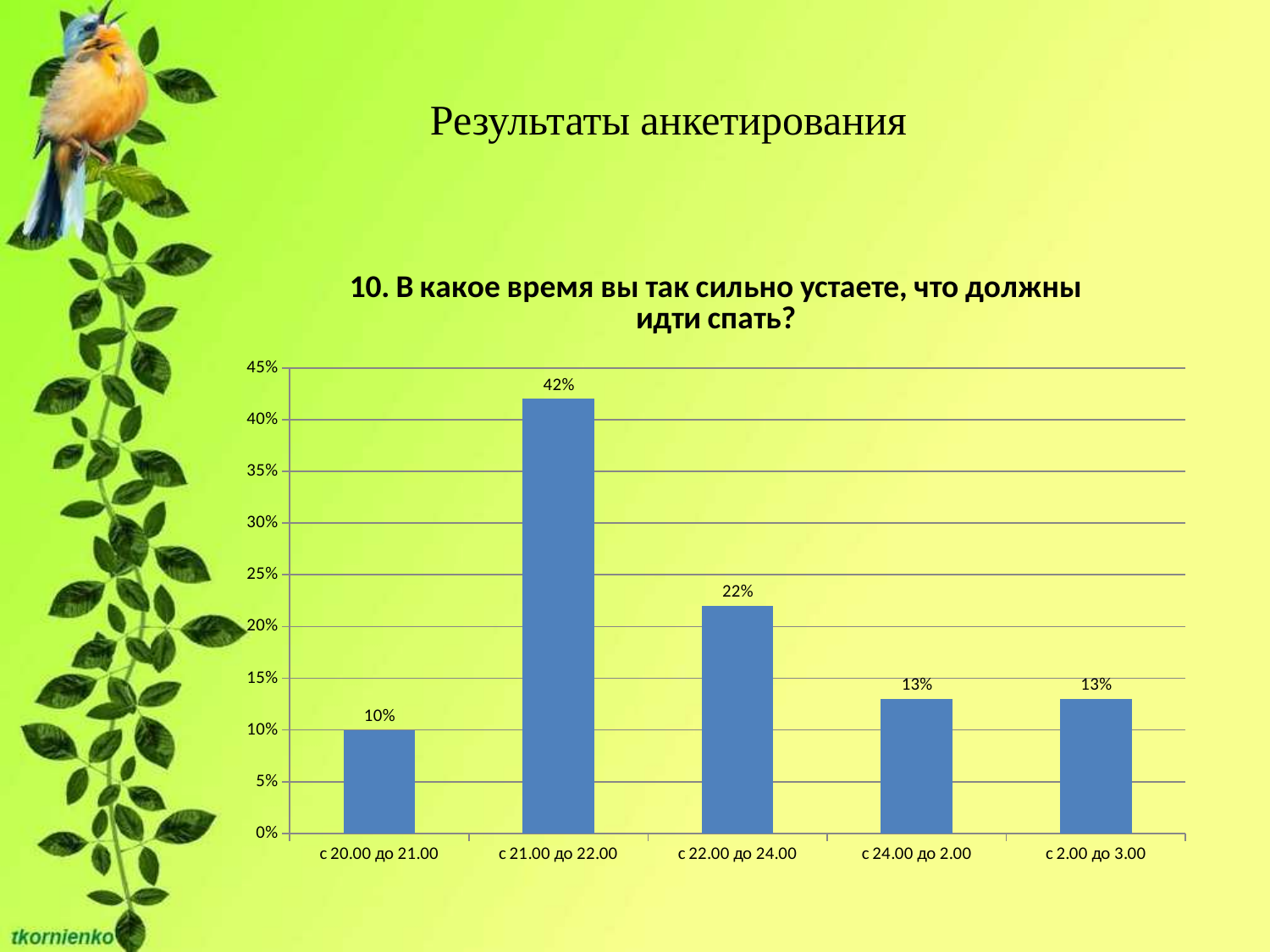
What is the value for the category "с 24.00 до 2.00"? 13% Which category has the highest value? с 21.00 до 22.00 How many categories are shown on the x axis? 5 What is the title of the chart? 10. В какое время вы так сильно устаете, что должны идти спать? Is the value for "с 21.00 до 22.00" greater or less than 40%? greater Which is larger, the value for "с 22.00 до 24.00" or the value for "с 2.00 до 3.00"? с 22.00 до 24.00 What is the value for the category "с 22.00 до 24.00"? 22% What is the value for the category "с 21.00 до 22.00"? 42% Which category has the lowest value? с 20.00 до 21.00 What is the difference between the values for "с 21.00 до 22.00" and "с 22.00 до 24.00"? 20% What is the value for the category "с 20.00 до 21.00"? 10% What kind of chart is shown on the slide? bar chart